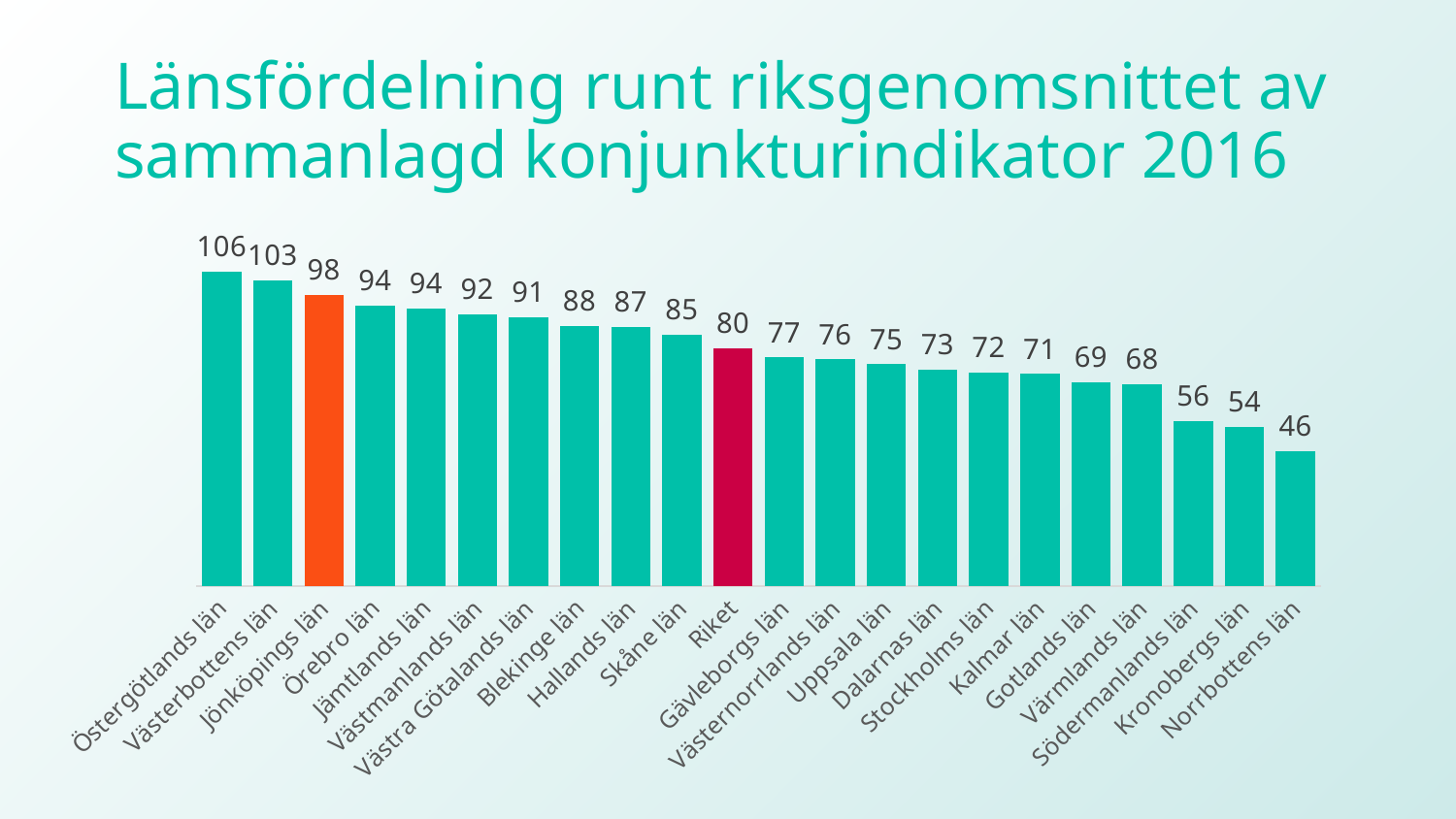
Which category has the highest value? Östergötlands län What is the difference between the values for Jönköpings län and Riket? 18 What is the value for Riket? 80 Which is larger, the value for Skåne län or the value for Gävleborgs län? Skåne län What is the value for Jönköpings län? 98 Which bar is coloured orange? Jönköpings län What kind of chart is shown on the slide? Bar chart Do the values rise or fall from left to right along the x axis? Fall What is the difference between the values for Östergötlands län and Norrbottens län? 60 Which category has the lowest value? Norrbottens län What is the value for Stockholms län? 72 How many bars are shown in the chart? 22